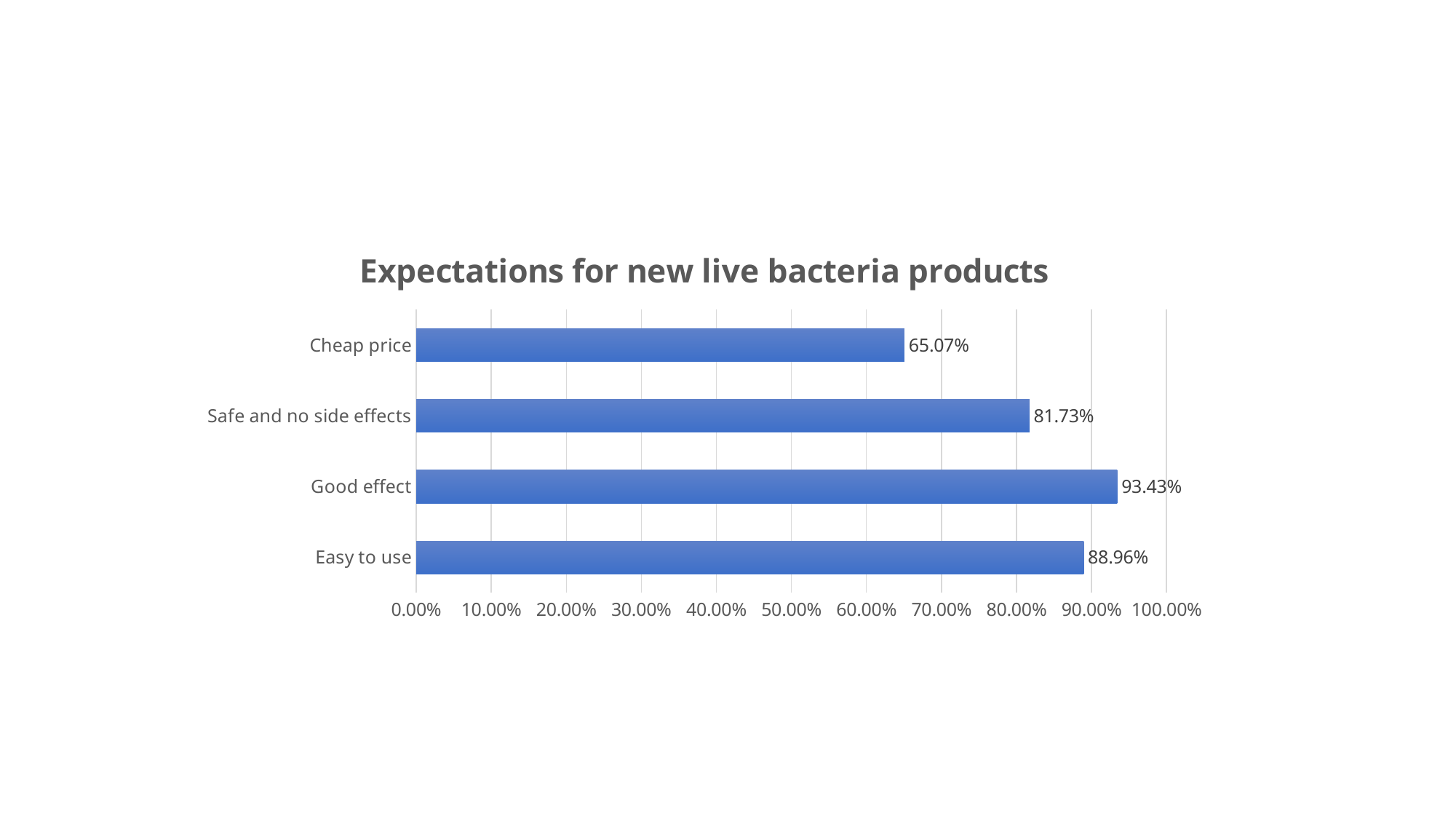
What kind of chart is shown on the slide? bar chart Which is larger, the value for Easy to use or the value for Safe and no side effects? Easy to use What is the value for Good effect? 93.43% What is the difference between the values for Good effect and Cheap price? 28.36% What is the value for Safe and no side effects? 81.73% What is the value for Cheap price? 65.07% Which category has the lowest value? Cheap price What is the title of the chart? Expectations for new live bacteria products Which category has the highest value? Good effect What is the value for Easy to use? 88.96% Is the value for Cheap price greater or less than 70.00%? less How many categories are shown in the chart? 4